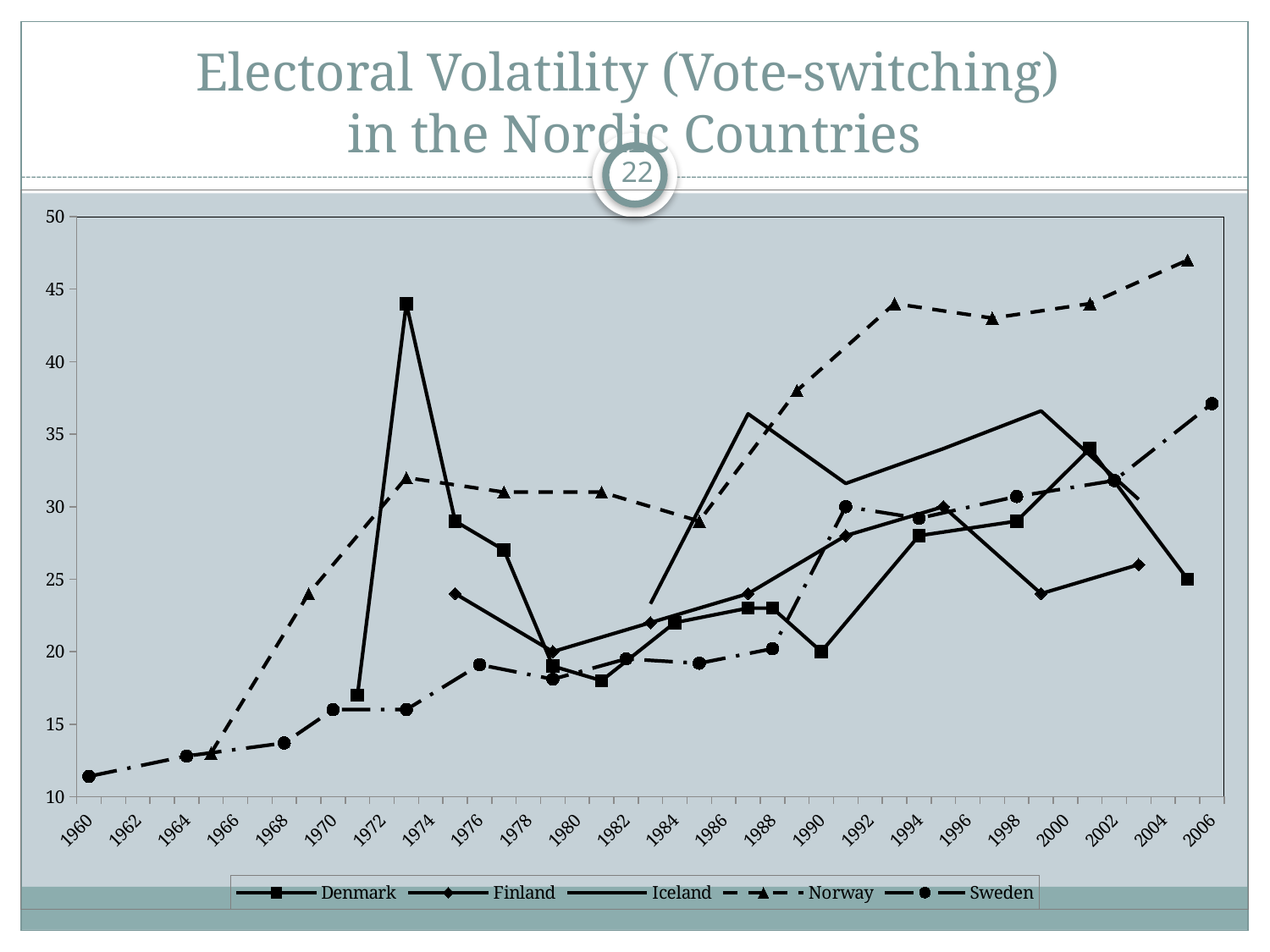
In 2005, which is larger: the value for Norway or the value for Denmark? Norway Does the Sweden series generally rise or fall from 1960 to 2006? rise How many series does the legend list? 5 Which series is drawn with a dashed line and triangle markers? Norway Is the value for Iceland in 1987 greater or less than 30? greater What kind of chart is shown on the slide? line chart Is the value for Sweden in 1960 greater or less than 15? less Is the value for Finland in 1999 greater or less than 30? less Which series reaches the highest value anywhere on the chart? Norway What is the title of the chart? Electoral Volatility (Vote-switching) in the Nordic Countries